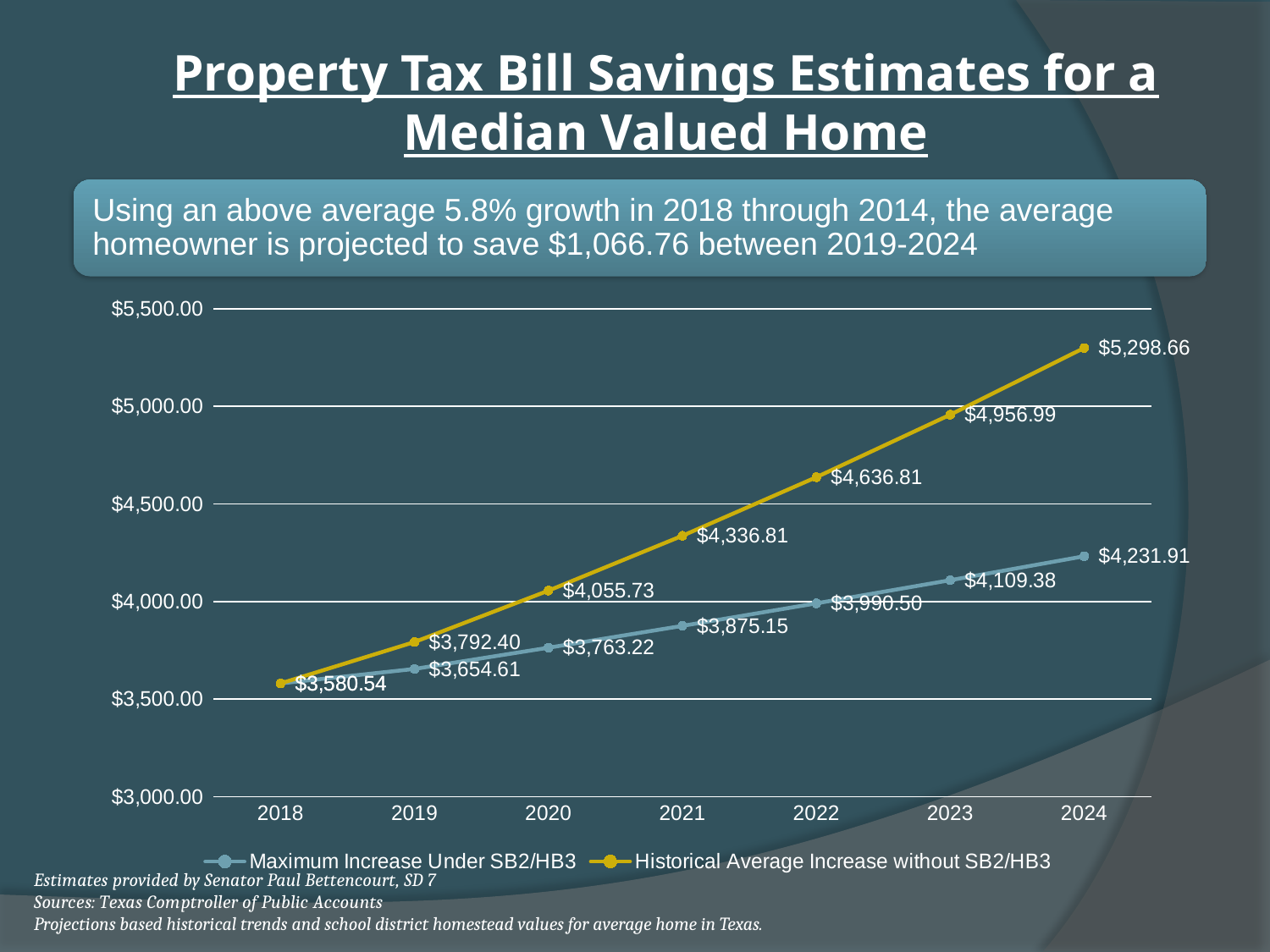
What is the value for Maximum Increase Under SB2/HB3 in 2021? $3,875.15 How many series does the legend list? 2 In which year does the Maximum Increase Under SB2/HB3 series reach its highest value? 2024 What is the value for Historical Average Increase without SB2/HB3 in 2024? $5,298.66 What is the value for Historical Average Increase without SB2/HB3 in 2020? $4,055.73 What kind of chart is shown on the slide? Line chart What is the difference between the two series' values in 2023? $847.61 How many years are plotted along the x axis? 7 Which series has the larger value in 2023, Maximum Increase Under SB2/HB3 or Historical Average Increase without SB2/HB3? Historical Average Increase without SB2/HB3 What is the value shown for 2018, where both series start? $3,580.54 In which year is the Historical Average Increase without SB2/HB3 series at its lowest value? 2018 Do the values for Maximum Increase Under SB2/HB3 rise or fall from 2018 to 2024? Rise